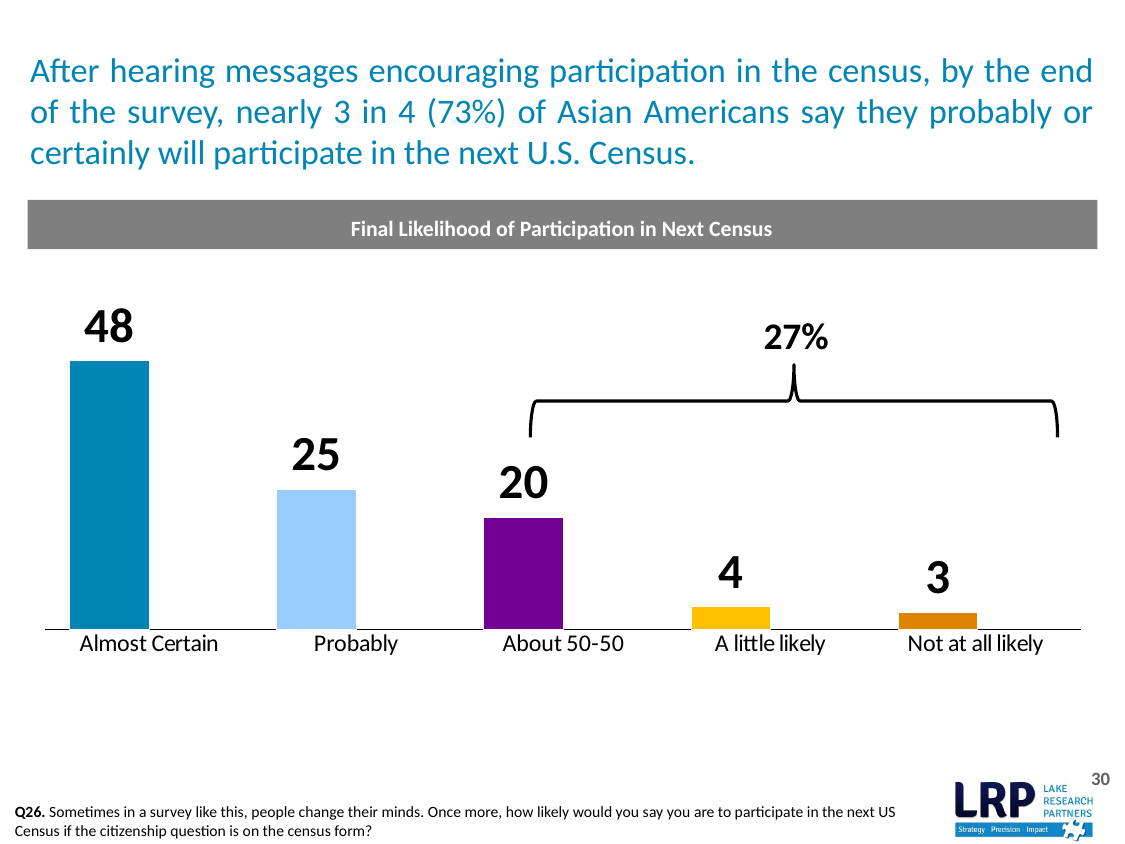
What kind of chart is shown? Bar chart What is the title of the chart? Final Likelihood of Participation in Next Census What is the value for About 50-50? 20 What is the value for Almost Certain? 48 Which category has the highest value? Almost Certain What is the value for Not at all likely? 3 How many categories are shown in the chart? 5 What is the difference between the values for About 50-50 and A little likely? 16 Which is larger, the value for Probably or the value for About 50-50? Probably What is the difference between the values for Almost Certain and Probably? 23 What is the value for Probably? 25 Which category has the lowest value? Not at all likely